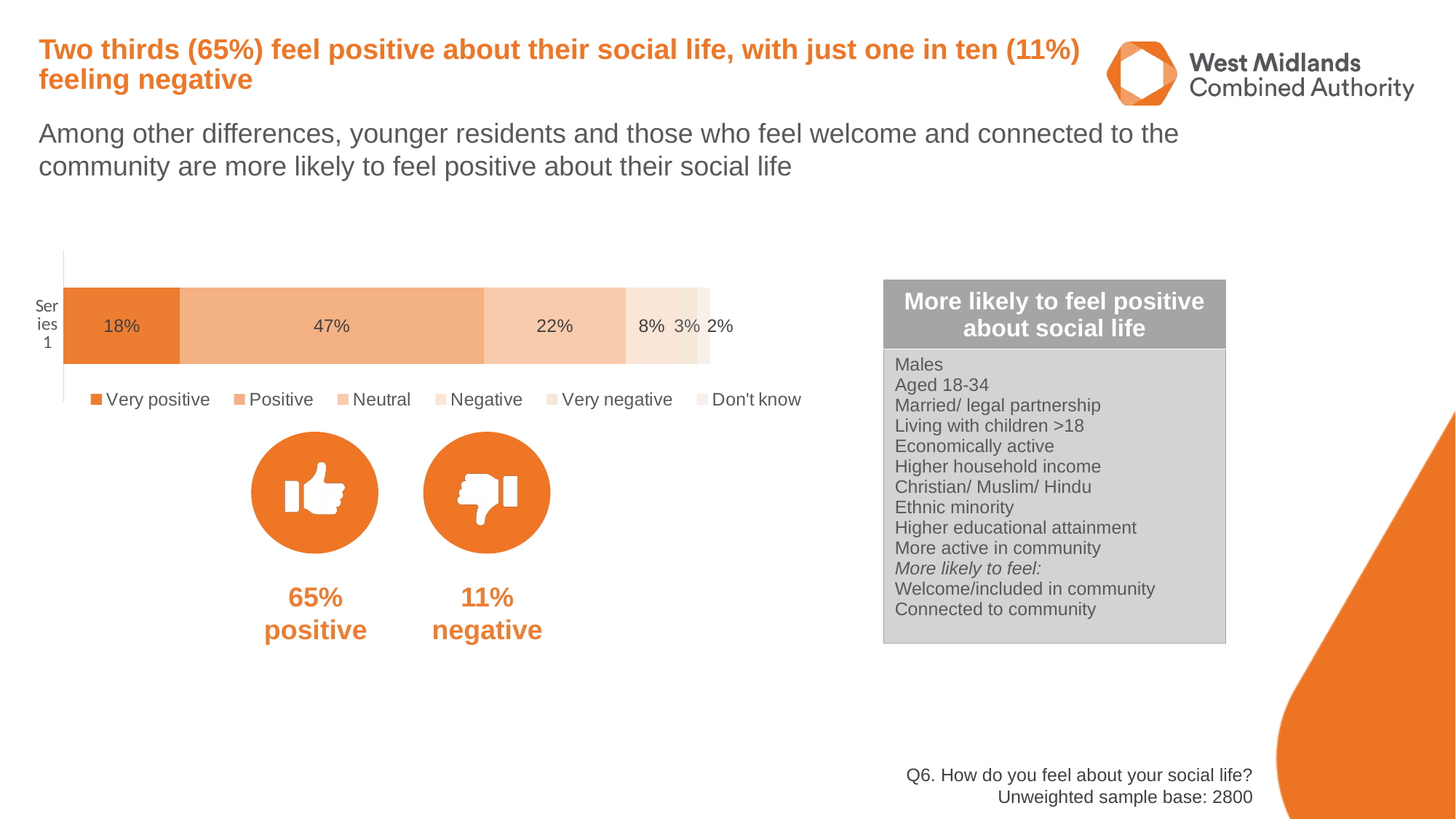
What percentage of respondents feel negative about their social life? 8% What percentage of respondents answered 'Don't know'? 2% What is the difference between the Positive and Neutral shares? 25% Which response category has the smallest share in the bar? Don't know Which response category has the largest share in the bar? Positive What is the combined share of Very positive and Positive responses? 65% Which is larger, the Very positive share or the Neutral share? Neutral What percentage of respondents feel neutral about their social life? 22% What kind of chart is shown on the slide? Stacked bar chart What percentage of respondents feel very positive about their social life? 18% What percentage of respondents feel positive (not very positive) about their social life? 47% How many response categories does the legend list? 6